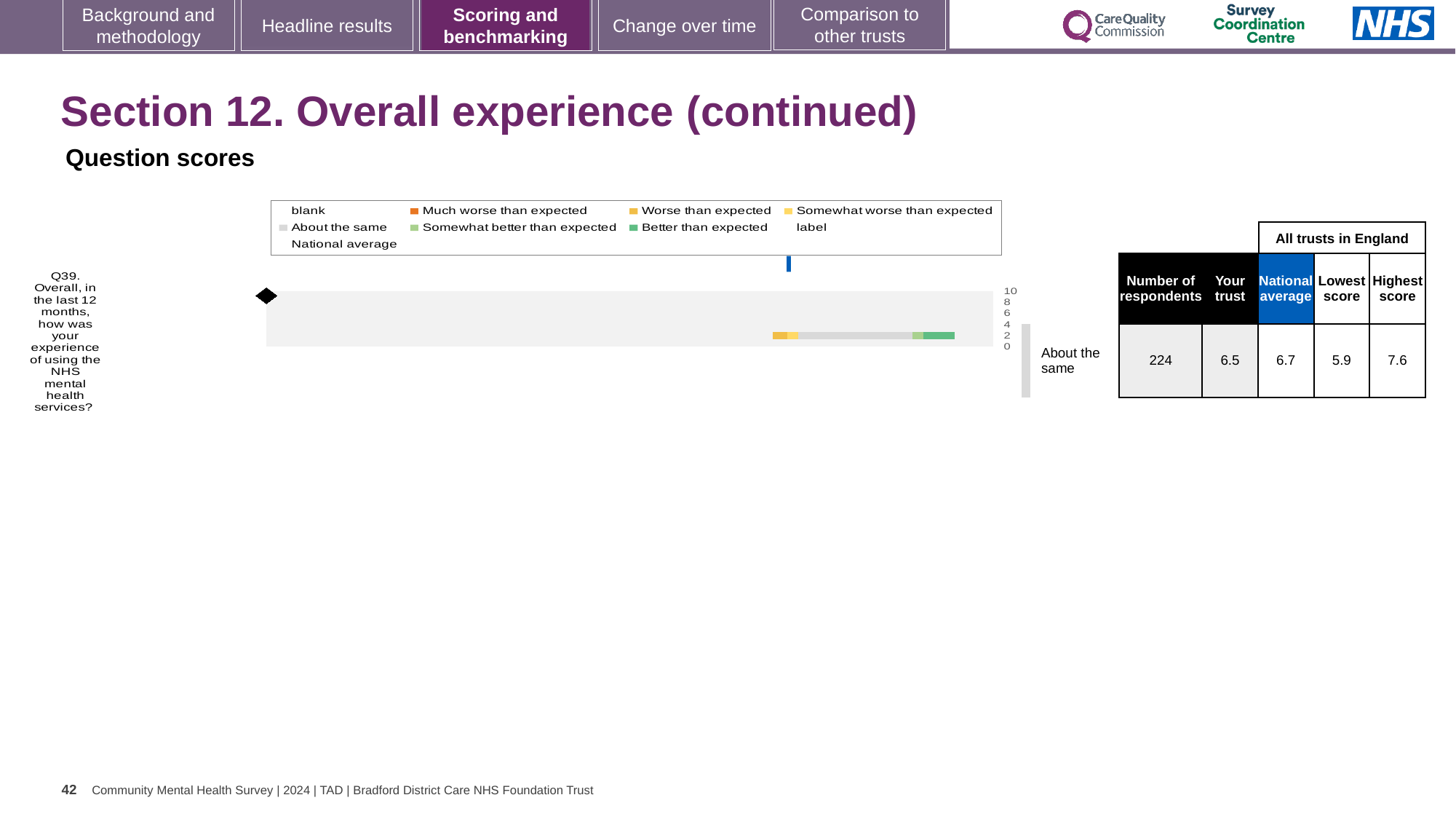
What is the national average score for Q39 shown on the slide? 6.7 What is the highest score among all trusts in England for Q39? 7.6 How many questions are plotted on the chart on this slide? 1 Which benchmarking category is the trust's Q39 result placed in? About the same What is the difference between the highest and lowest scores among all trusts in England for Q39? 1.7 What kind of chart is used to show the Q39 benchmarking result? Bar chart Which is larger for Q39: the trust's score or the national average? National average What is the score for 'Your trust' for Q39 shown on the slide? 6.5 What is the difference between the national average and the trust's score for Q39? 0.2 How many respondents answered Q39? 224 Is the trust's score for Q39 greater or less than 6? greater What is the lowest score among all trusts in England for Q39? 5.9